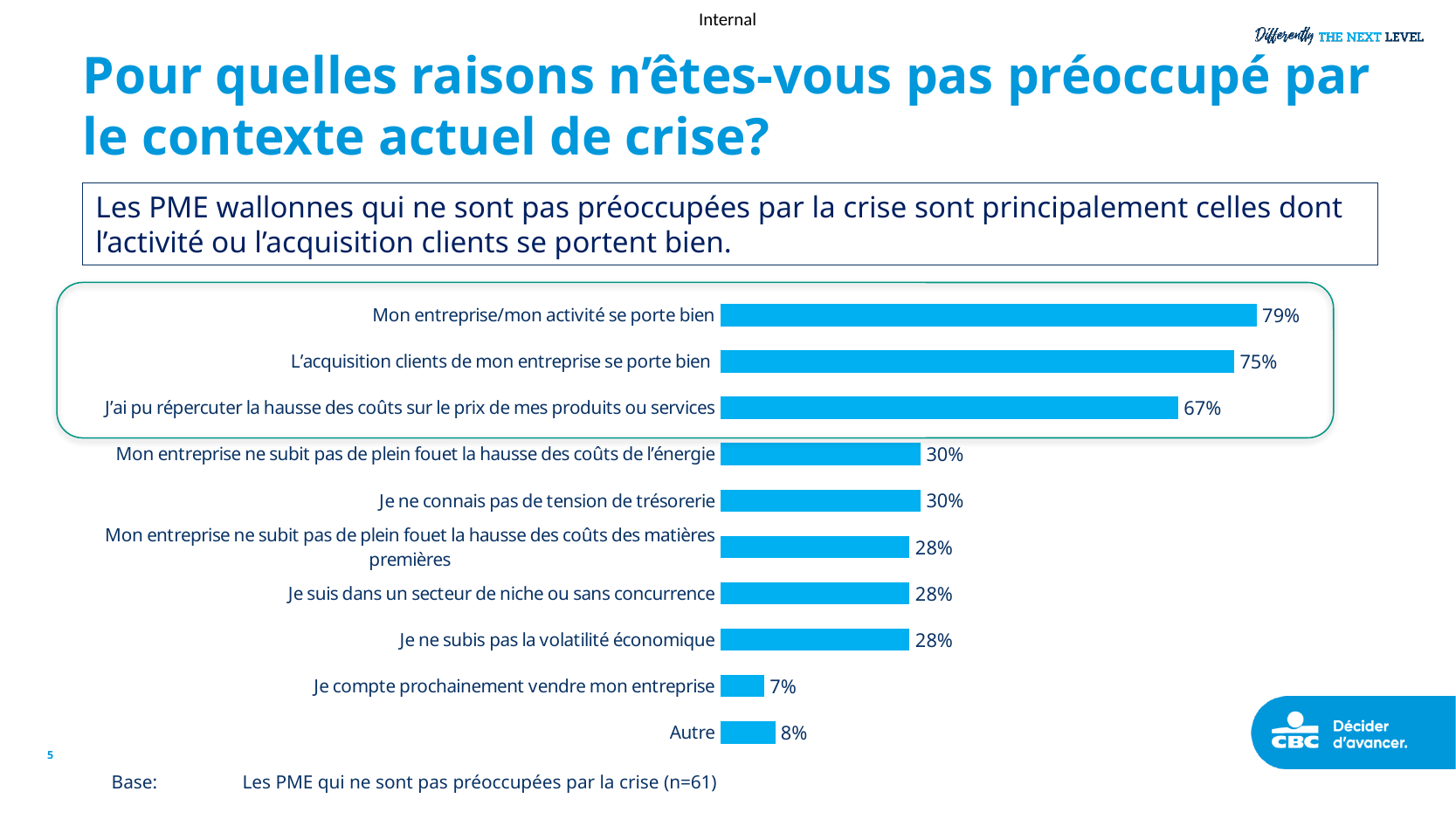
What is the difference between "L'acquisition clients de mon entreprise se porte bien" and "Je ne connais pas de tension de trésorerie"? 45% What is the difference between "Mon entreprise/mon activité se porte bien" and "L'acquisition clients de mon entreprise se porte bien"? 4% Which category has the lowest value? Je compte prochainement vendre mon entreprise What is the value for "Je compte prochainement vendre mon entreprise"? 7% Which category has the highest value? Mon entreprise/mon activité se porte bien What is the value for "Autre"? 8% What is the value for "J'ai pu répercuter la hausse des coûts sur le prix de mes produits ou services"? 67% Which is larger: "Je suis dans un secteur de niche ou sans concurrence" or "Mon entreprise ne subit pas de plein fouet la hausse des coûts de l'énergie"? Mon entreprise ne subit pas de plein fouet la hausse des coûts de l'énergie What kind of chart is shown on the slide? Bar chart What is the base (n) stated below the chart? n=61 What is the value for "Mon entreprise/mon activité se porte bien"? 79% How many categories are shown in the chart? 10